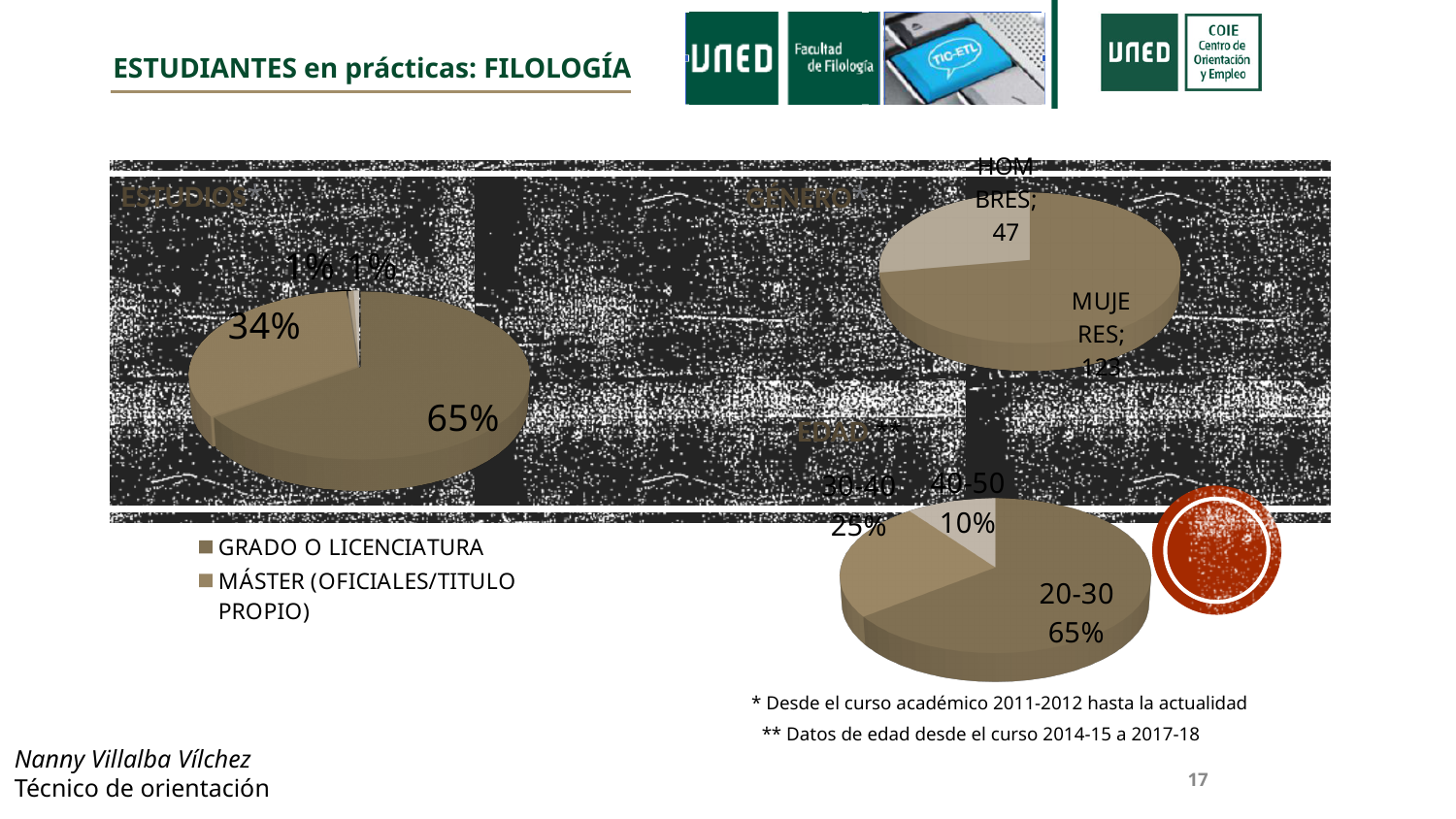
In the GÉNERO* chart, what is the difference between MUJERES and HOMBRES? 76 In the EDAD** chart, which age group has the smallest share? 40-50 In the GÉNERO* chart, what is the value for HOMBRES? 47 In the ESTUDIOS* chart, what is the percentage of the largest slice? 65% In the EDAD** chart, which age group has the largest share? 20-30 In the GÉNERO* chart, which category is larger, HOMBRES or MUJERES? MUJERES In the EDAD** chart, what is the difference in percentage points between the 30-40 and 40-50 groups? 15 What type of chart is the ESTUDIOS* chart? Pie chart In the EDAD** chart, what percentage is shown for the 40-50 age group? 10% In the GÉNERO* chart, what is the value for MUJERES? 123 In the EDAD** chart, what percentage is shown for the 20-30 age group? 65% In the EDAD** chart, what percentage is shown for the 30-40 age group? 25%